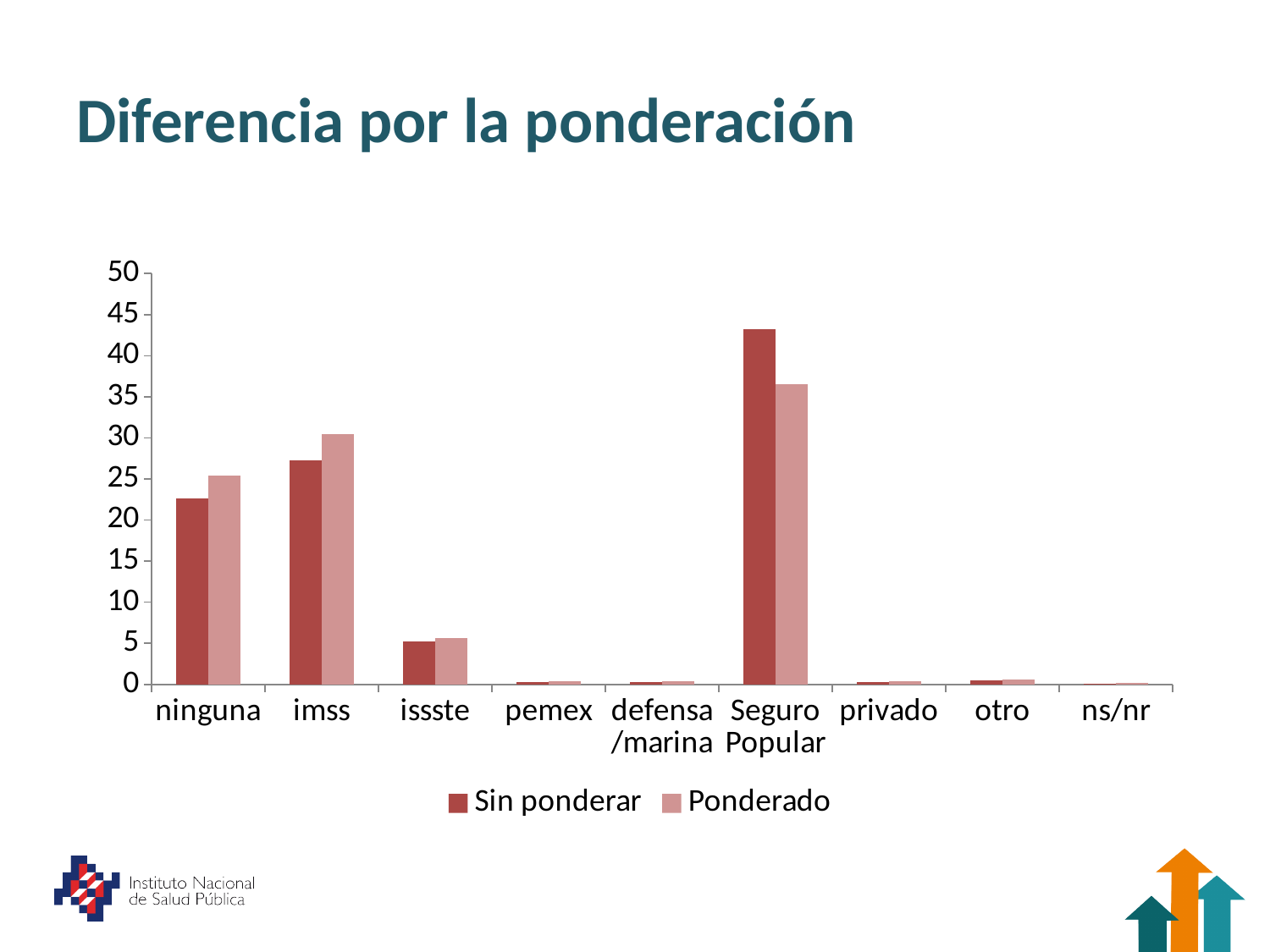
Which category has the highest value for the Ponderado series? Seguro Popular Is the Sin ponderar value for Seguro Popular greater or less than 40? greater Is the Sin ponderar value for ninguna greater or less than 25? less For imss, which series has the larger value, Sin ponderar or Ponderado? Ponderado How many categories are shown on the x axis? 9 For Seguro Popular, which series has the larger value, Sin ponderar or Ponderado? Sin ponderar What kind of chart is shown on the slide? bar chart Which category has the highest value for the Sin ponderar series? Seguro Popular Is the Ponderado value for Seguro Popular greater or less than 40? less How many series does the legend list? 2 What is the title of the slide? Diferencia por la ponderación For ninguna, which series has the larger value, Sin ponderar or Ponderado? Ponderado